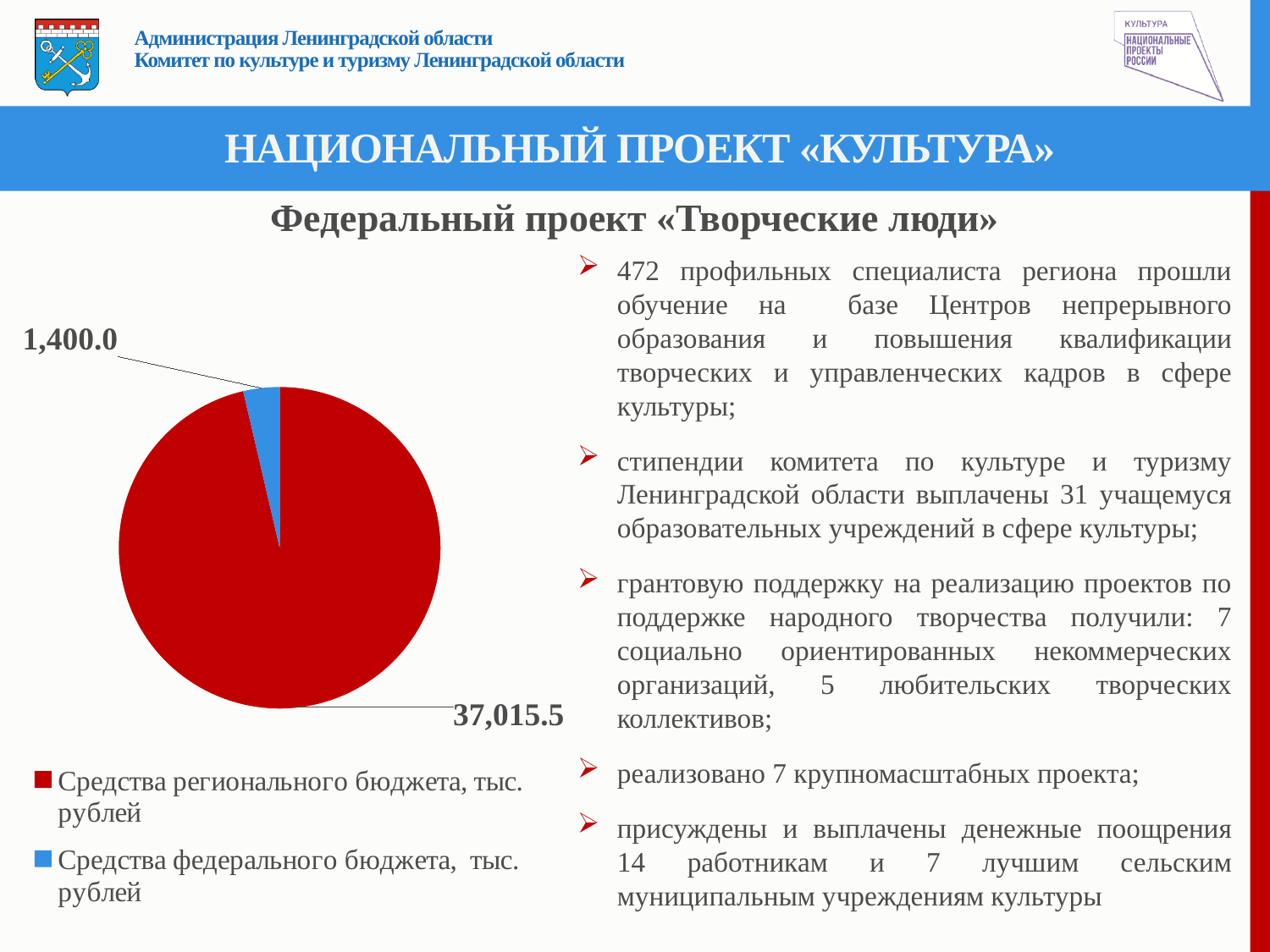
Which category has the largest slice in the pie chart? Средства регионального бюджета, тыс. рублей What colour is the slice for «Средства регионального бюджета, тыс. рублей»? Red How many entries does the legend of the chart list? 2 What kind of chart is shown on the slide? Pie chart What is the total of the two values shown in the pie chart? 38,415.5 What is the difference between the regional budget value and the federal budget value in the pie chart? 35,615.5 How many slices does the pie chart have? 2 What is the value for «Средства федерального бюджета, тыс. рублей» in the pie chart? 1,400.0 What share of the pie chart does the federal budget slice represent? 3.6% What is the value for «Средства регионального бюджета, тыс. рублей» in the pie chart? 37,015.5 Which is larger in the pie chart: the regional budget funds or the federal budget funds? Средства регионального бюджета, тыс. рублей Which category has the smallest slice in the pie chart? Средства федерального бюджета, тыс. рублей